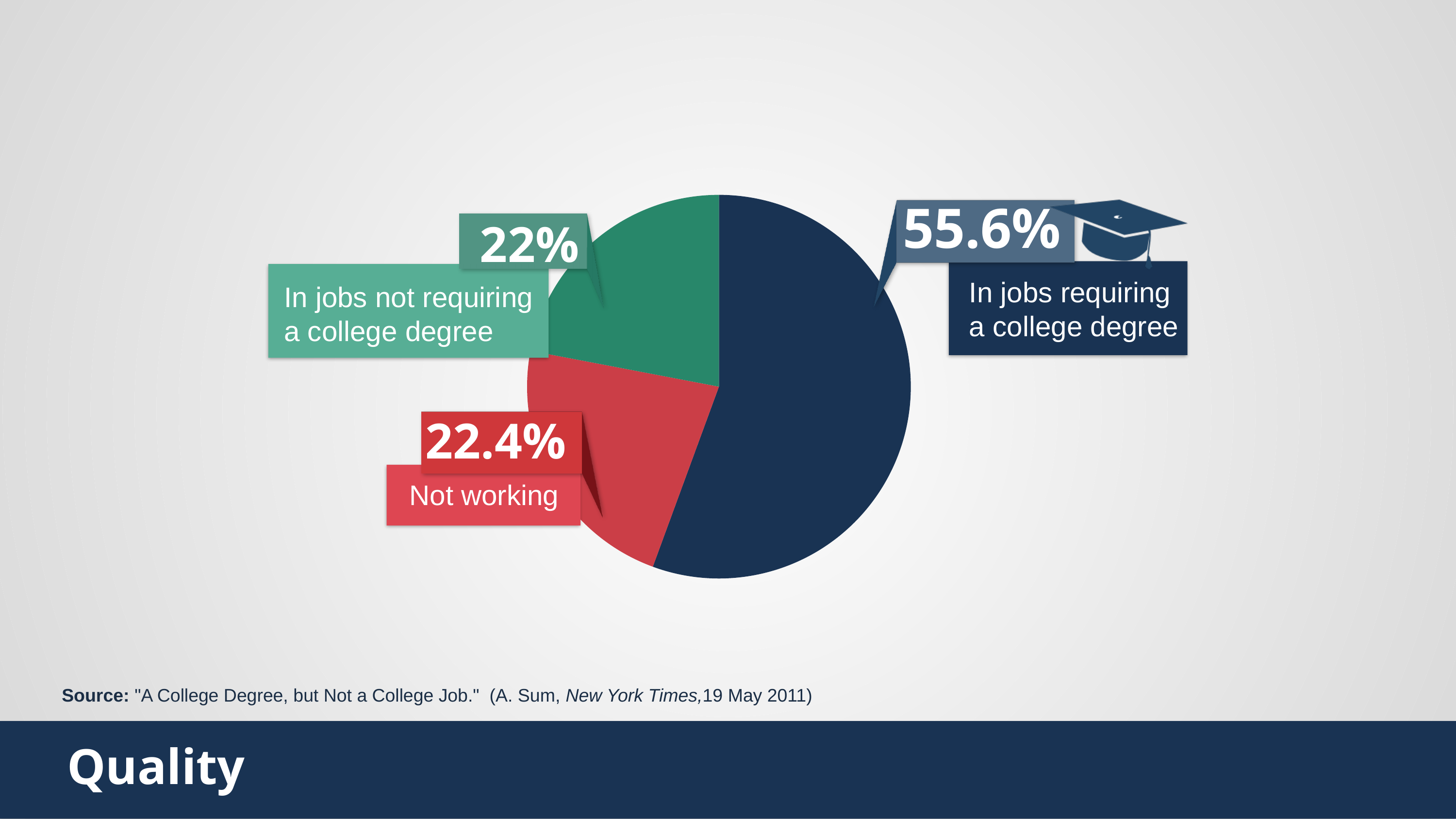
What percentage is shown for "In jobs not requiring a college degree"? 22% What colour is the slice for "Not working"? Red What colour is the slice for "In jobs not requiring a college degree"? Green What share of the pie is labelled "In jobs requiring a college degree"? 55.6% Which category has the largest slice of the pie? In jobs requiring a college degree What is the difference in percentage points between "In jobs requiring a college degree" and "Not working"? 33.2 What is the difference in percentage points between "In jobs requiring a college degree" and "In jobs not requiring a college degree"? 33.6 What percentage is shown for "Not working"? 22.4% What kind of chart is shown on the slide? Pie chart How many slices does the pie chart have? 3 Which is larger: the slice for "In jobs requiring a college degree" or the slice for "Not working"? In jobs requiring a college degree Is the share for "In jobs requiring a college degree" greater or less than 50%? greater